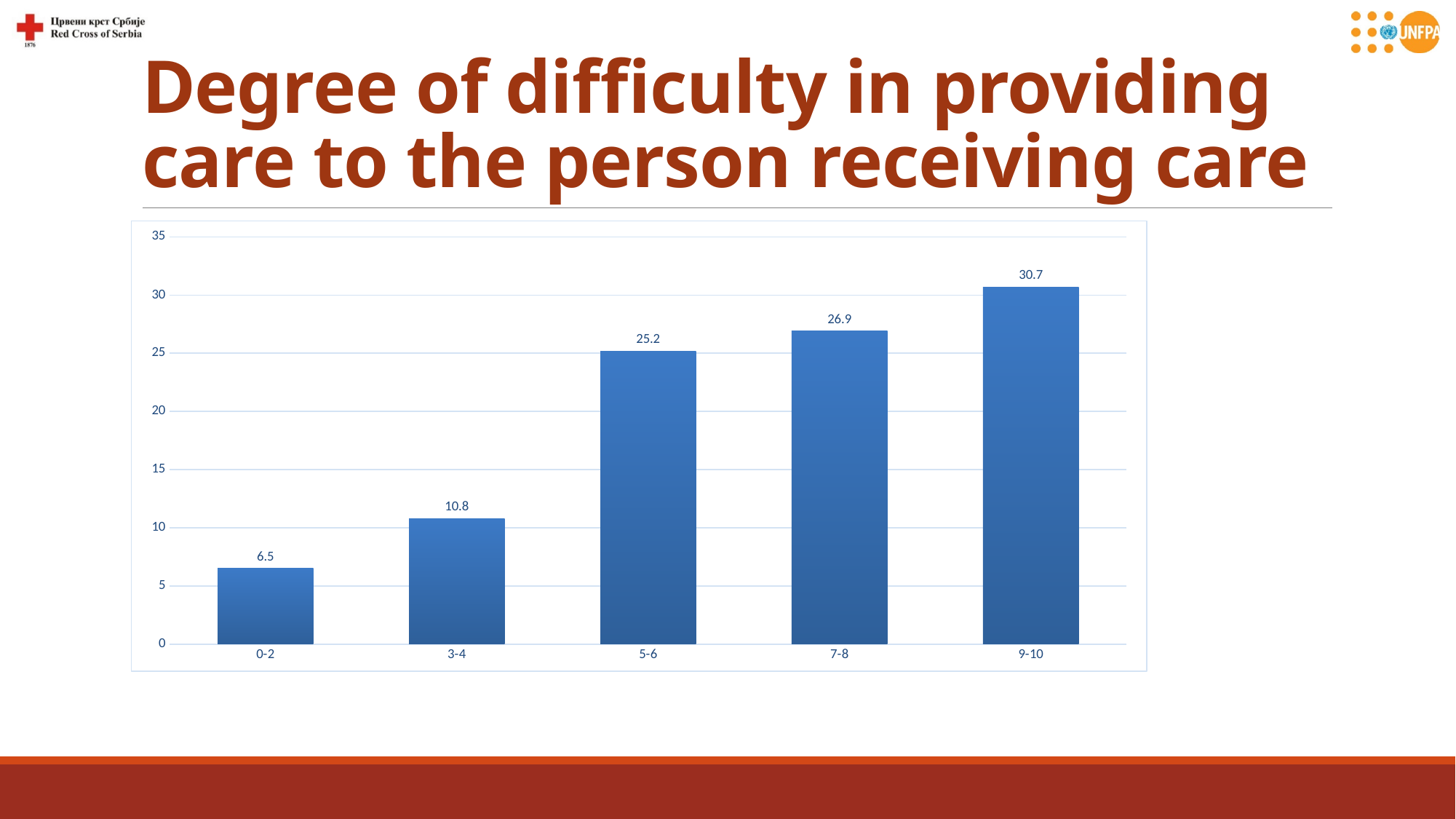
What is the difference between the values for 5-6 and 3-4? 14.4 What is the value for the 9-10 category? 30.7 How many categories are shown on the x axis? 5 What is the value for the 0-2 category? 6.5 What kind of chart is shown on the slide? bar chart Which is larger, the value for 3-4 or the value for 5-6? 5-6 Which category has the lowest value? 0-2 Which category has the highest value? 9-10 Is the value for 7-8 greater or less than 25? greater Do the values rise or fall from left to right along the x axis? rise What is the difference between the values for 9-10 and 7-8? 3.8 What is the value for the 5-6 category? 25.2